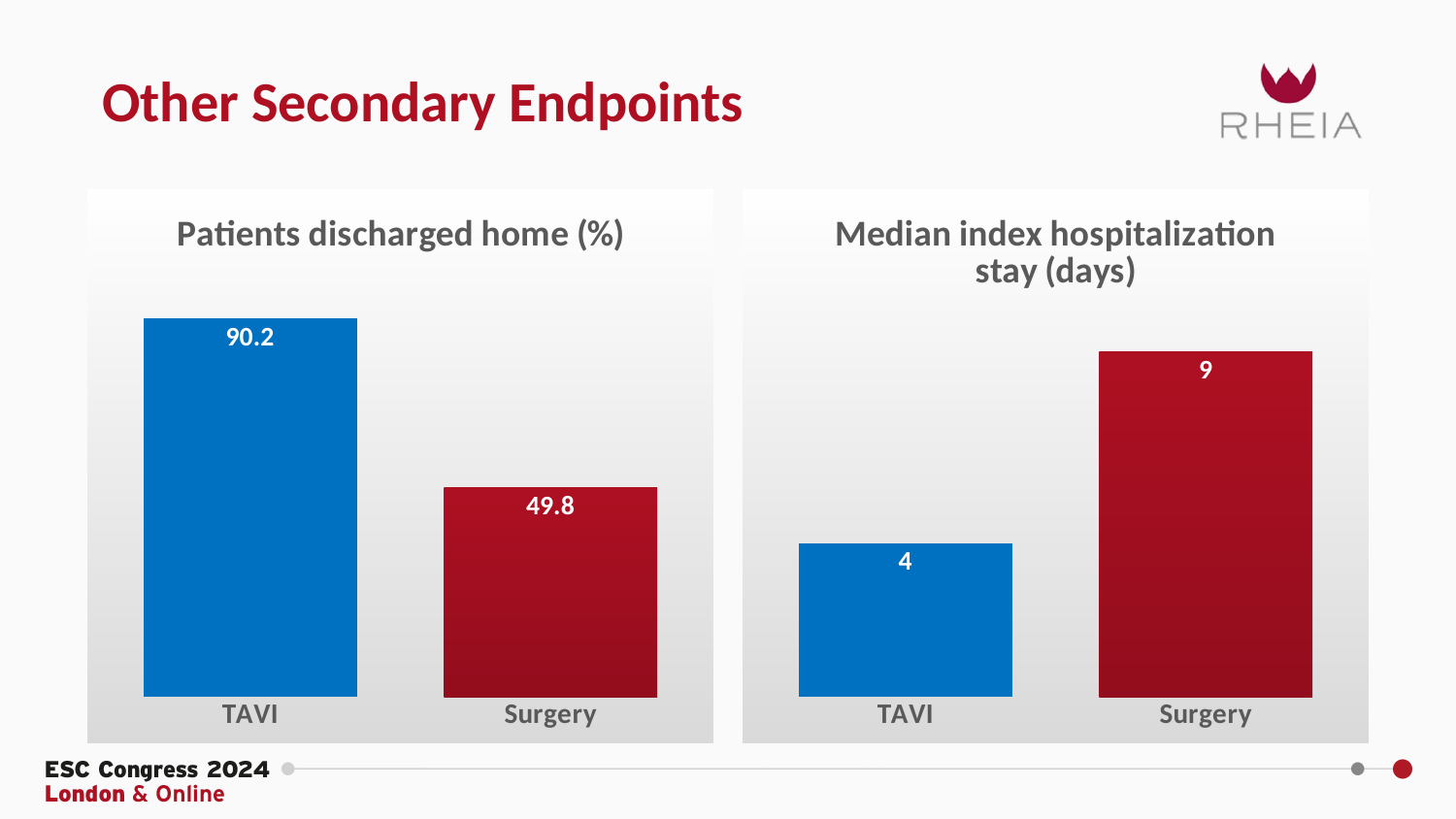
In the 'Patients discharged home (%)' chart, which category has the highest value? TAVI In the 'Patients discharged home (%)' chart, what is the value for TAVI? 90.2 In the 'Median index hospitalization stay (days)' chart, what is the value for TAVI? 4 In the 'Patients discharged home (%)' chart, what colour is the TAVI bar? Blue How many categories are shown in the 'Patients discharged home (%)' chart? 2 In the 'Median index hospitalization stay (days)' chart, which category has the lowest value? TAVI In the 'Median index hospitalization stay (days)' chart, which is larger, the value for TAVI or for Surgery? Surgery In the 'Median index hospitalization stay (days)' chart, what is the value for Surgery? 9 In the 'Patients discharged home (%)' chart, what is the difference between the TAVI and Surgery values? 40.4 What kind of chart is the 'Median index hospitalization stay (days)' chart? Bar chart In the 'Median index hospitalization stay (days)' chart, what is the difference between the Surgery and TAVI values? 5 In the 'Patients discharged home (%)' chart, what is the value for Surgery? 49.8